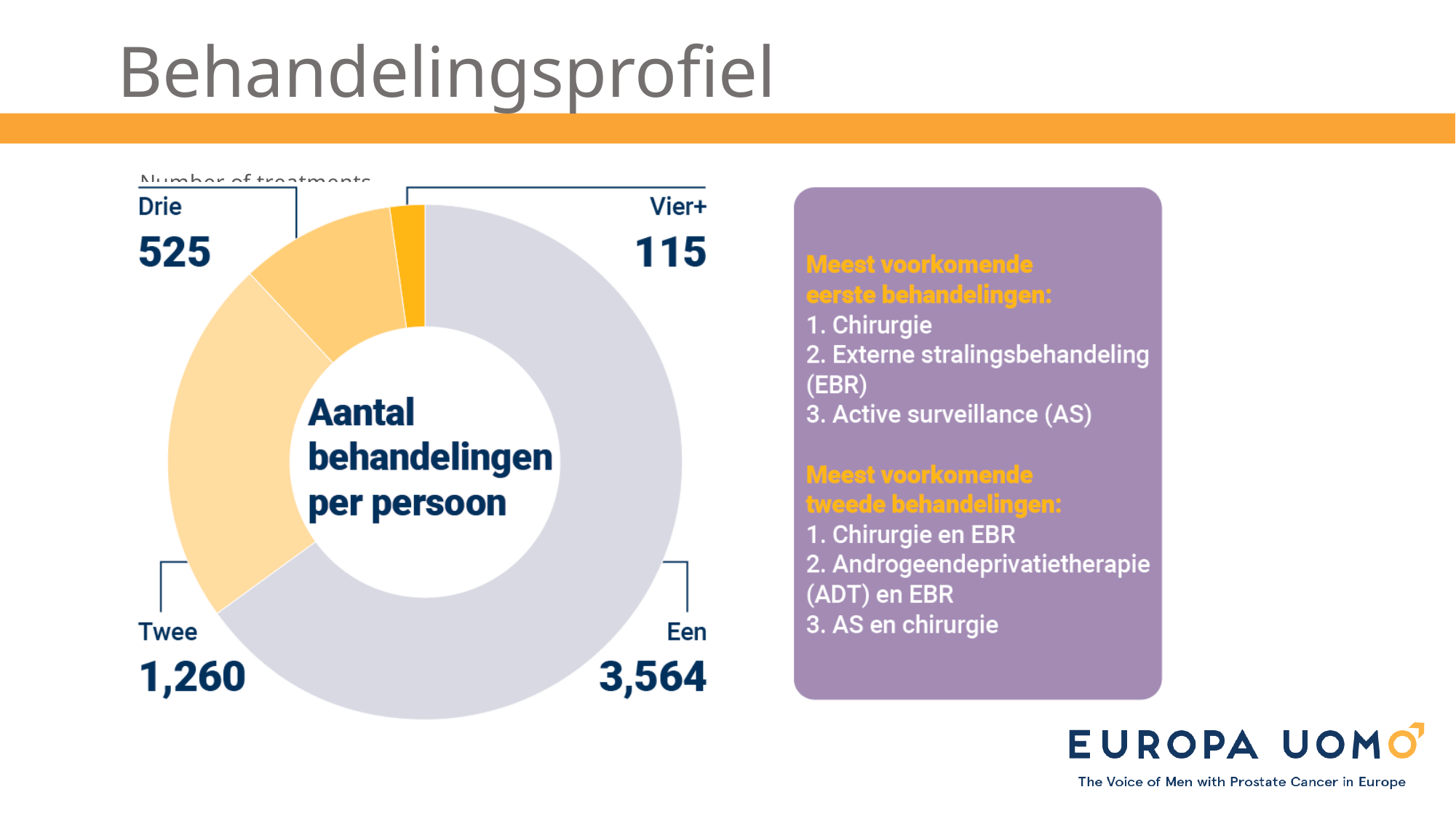
Which is larger, the value for 'Twee' or the value for 'Drie'? Twee What is the difference between the values for 'Een' and 'Twee'? 2,304 What text is written in the centre of the donut chart? Aantal behandelingen per persoon What is the value for the 'Een' segment? 3,564 What kind of chart is shown on the slide? Donut (pie) chart What is the value for the 'Vier+' segment? 115 Which category has the lowest value? Vier+ Which category has the highest value? Een What is the value for the 'Drie' segment? 525 What is the difference between the values for 'Drie' and 'Vier+'? 410 How many categories does the donut chart show? 4 What is the value for the 'Twee' segment? 1,260